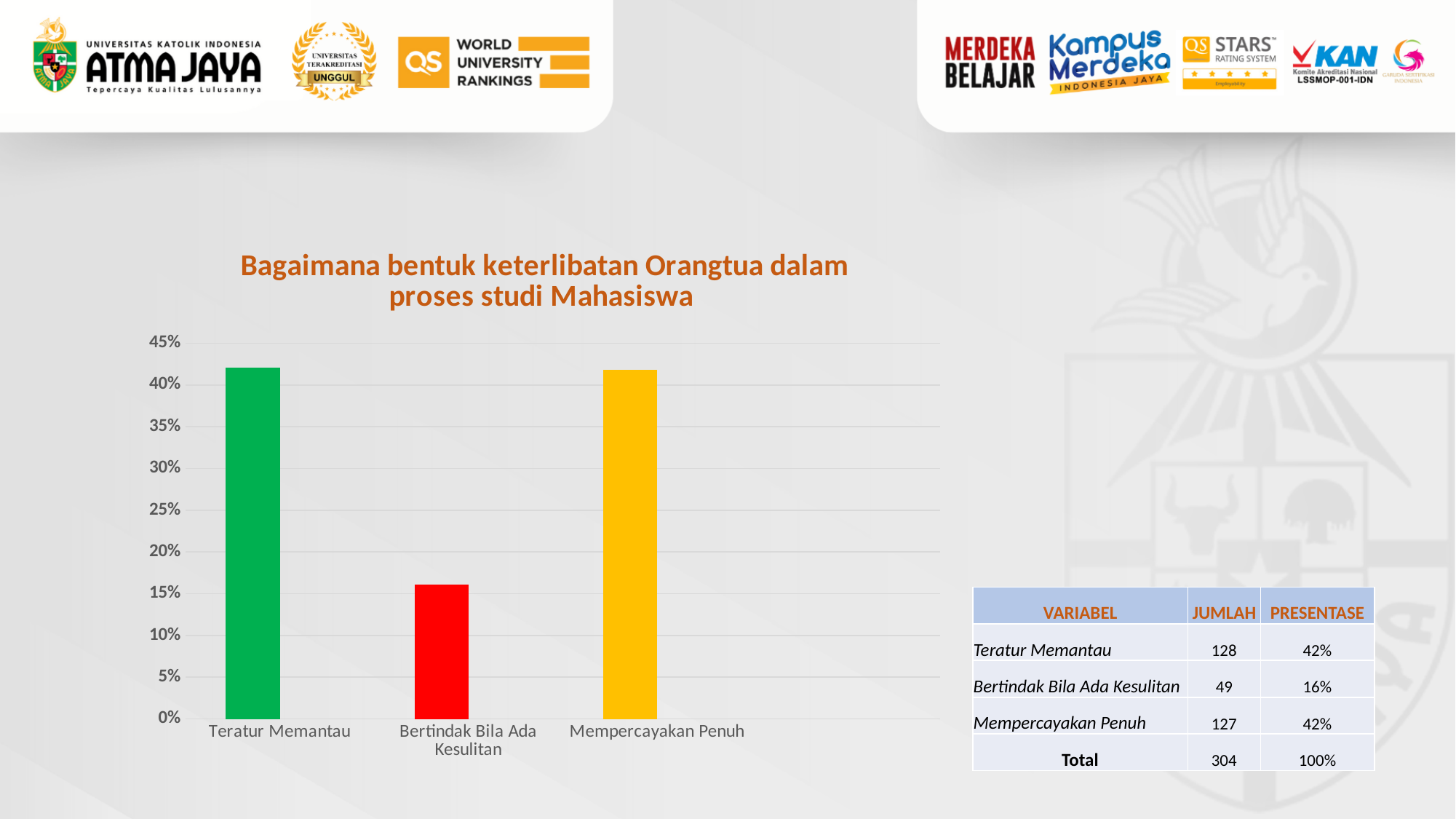
What is the title of the chart? Bagaimana bentuk keterlibatan Orangtua dalam proses studi Mahasiswa Which is larger, the value for Teratur Memantau or the value for Bertindak Bila Ada Kesulitan? Teratur Memantau Is the value for Bertindak Bila Ada Kesulitan greater or less than 20%? less Which is larger, the value for Mempercayakan Penuh or the value for Bertindak Bila Ada Kesulitan? Mempercayakan Penuh How many categories are shown on the x axis of the chart? 3 Using the percentages in the table, what is the difference between Teratur Memantau and Bertindak Bila Ada Kesulitan? 26% According to the table on the slide, what percentage is shown for Teratur Memantau? 42% Is the value for Mempercayakan Penuh greater or less than 35%? greater What kind of chart is shown on the slide? bar chart Which category has the lowest bar in the chart? Bertindak Bila Ada Kesulitan According to the table on the slide, what percentage is shown for Bertindak Bila Ada Kesulitan? 16% Is the value for Teratur Memantau greater or less than 40%? greater